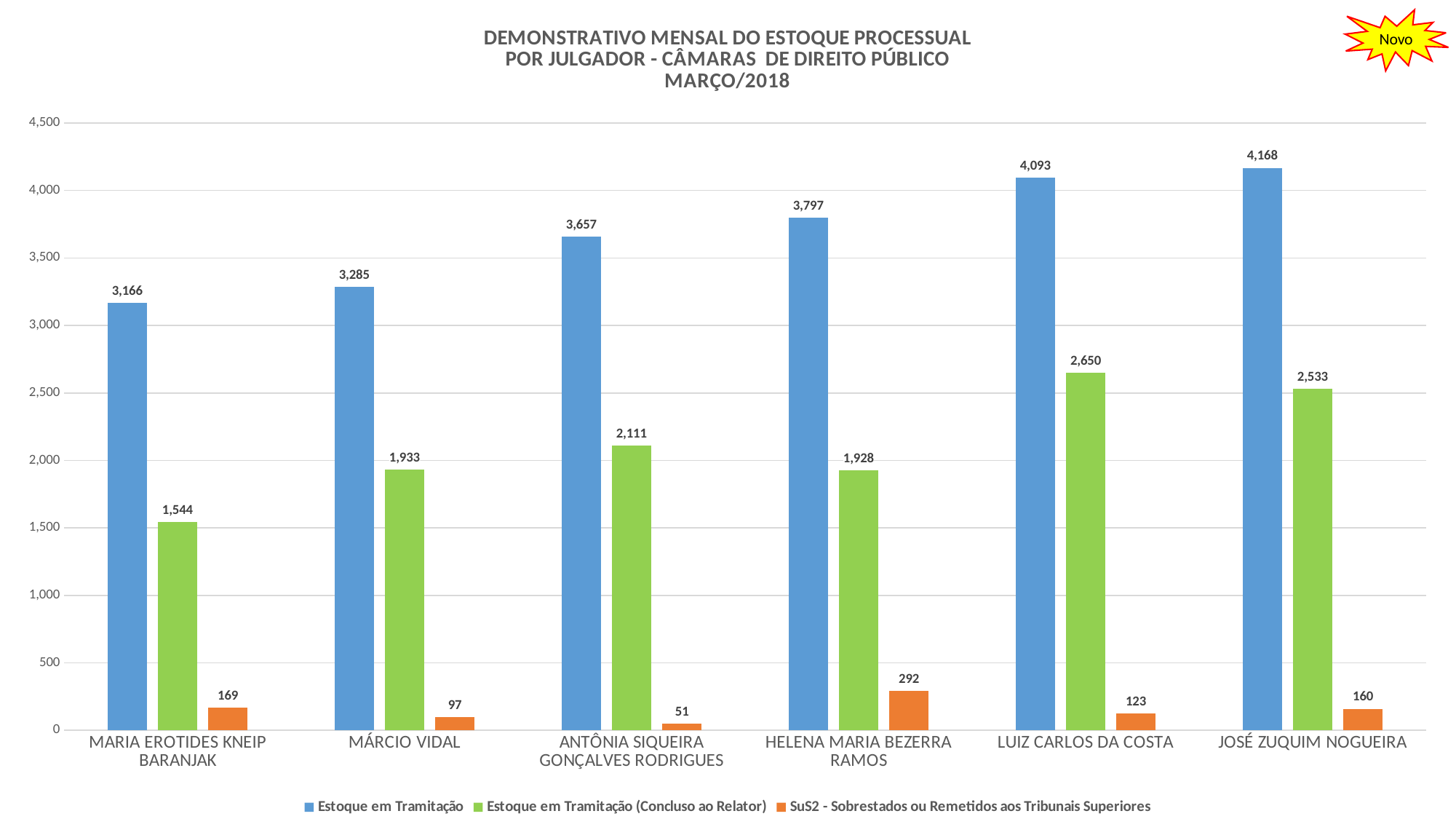
Which colour represents "SuS2 - Sobrestados ou Remetidos aos Tribunais Superiores" in the legend? Orange How many judges are shown on the x axis? 6 What is the value of "Estoque em Tramitação" for MÁRCIO VIDAL? 3,285 Is the "Estoque em Tramitação" value for MARIA EROTIDES KNEIP BARANJAK greater or less than 3,000? greater What is the value of "Estoque em Tramitação (Concluso ao Relator)" for LUIZ CARLOS DA COSTA? 2,650 What kind of chart is shown on the slide? Bar chart Which judge has the lowest value for "SuS2 - Sobrestados ou Remetidos aos Tribunais Superiores"? ANTÔNIA SIQUEIRA GONÇALVES RODRIGUES Which judge has the highest value for "Estoque em Tramitação"? JOSÉ ZUQUIM NOGUEIRA How many series does the legend list? 3 Which is larger: the "Estoque em Tramitação (Concluso ao Relator)" value for MÁRCIO VIDAL or for HELENA MARIA BEZERRA RAMOS? MÁRCIO VIDAL What is the value of "SuS2 - Sobrestados ou Remetidos aos Tribunais Superiores" for HELENA MARIA BEZERRA RAMOS? 292 What is the difference between the "Estoque em Tramitação" values for JOSÉ ZUQUIM NOGUEIRA and LUIZ CARLOS DA COSTA? 75